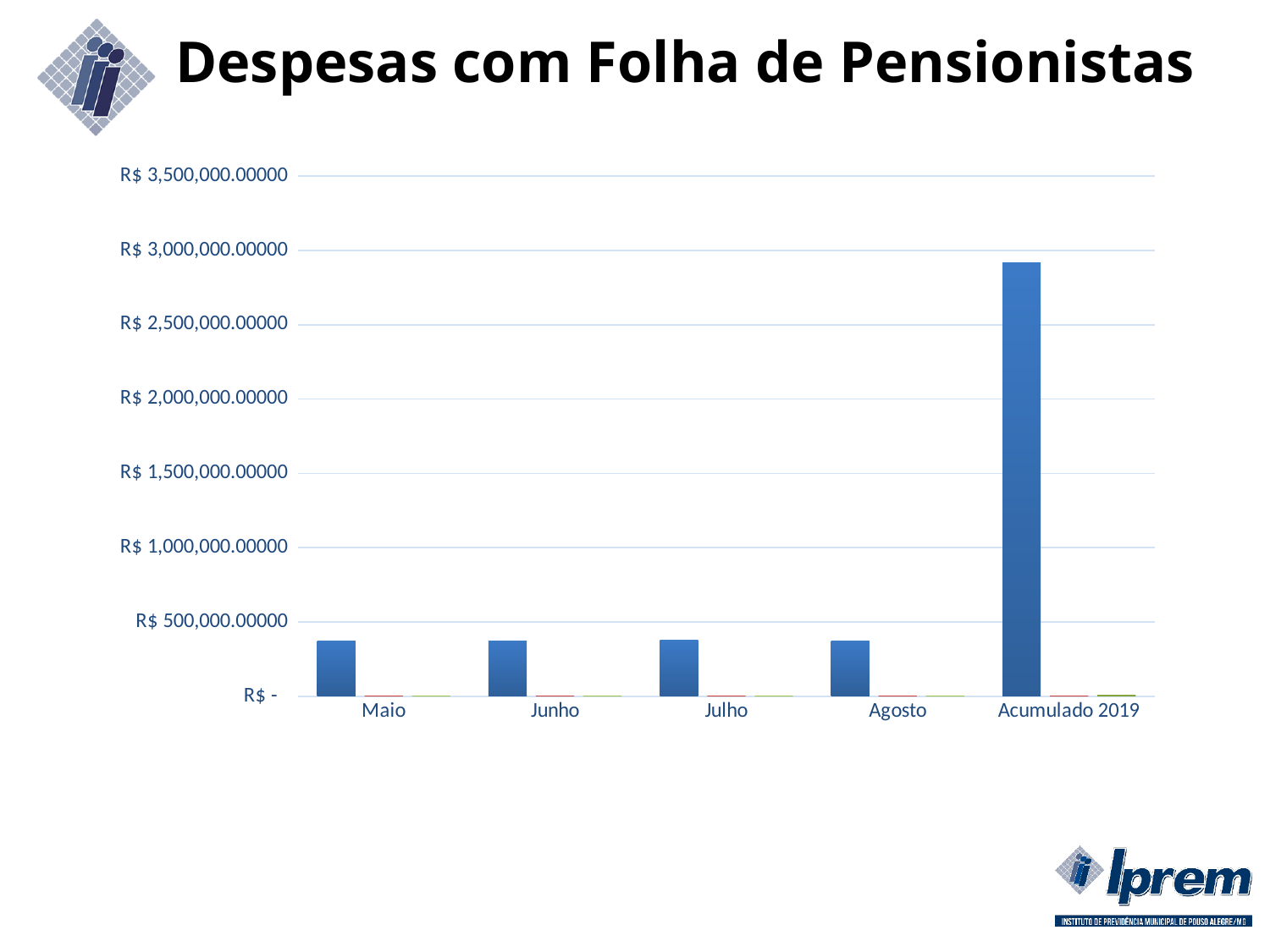
What is the title of the chart? Despesas com Folha de Pensionistas Which category has the highest blue bar? Acumulado 2019 Is the blue bar for Agosto greater or less than R$ 1,000,000.00000? less Is the blue bar for Acumulado 2019 greater or less than R$ 3,000,000.00000? less Is the blue bar for Acumulado 2019 greater or less than R$ 2,500,000.00000? greater How many categories are shown on the x axis? 5 What is the highest value labelled on the vertical axis? R$ 3,500,000.00000 What kind of chart is shown on the slide? bar chart Which is larger, the blue bar for Acumulado 2019 or the blue bar for Julho? Acumulado 2019